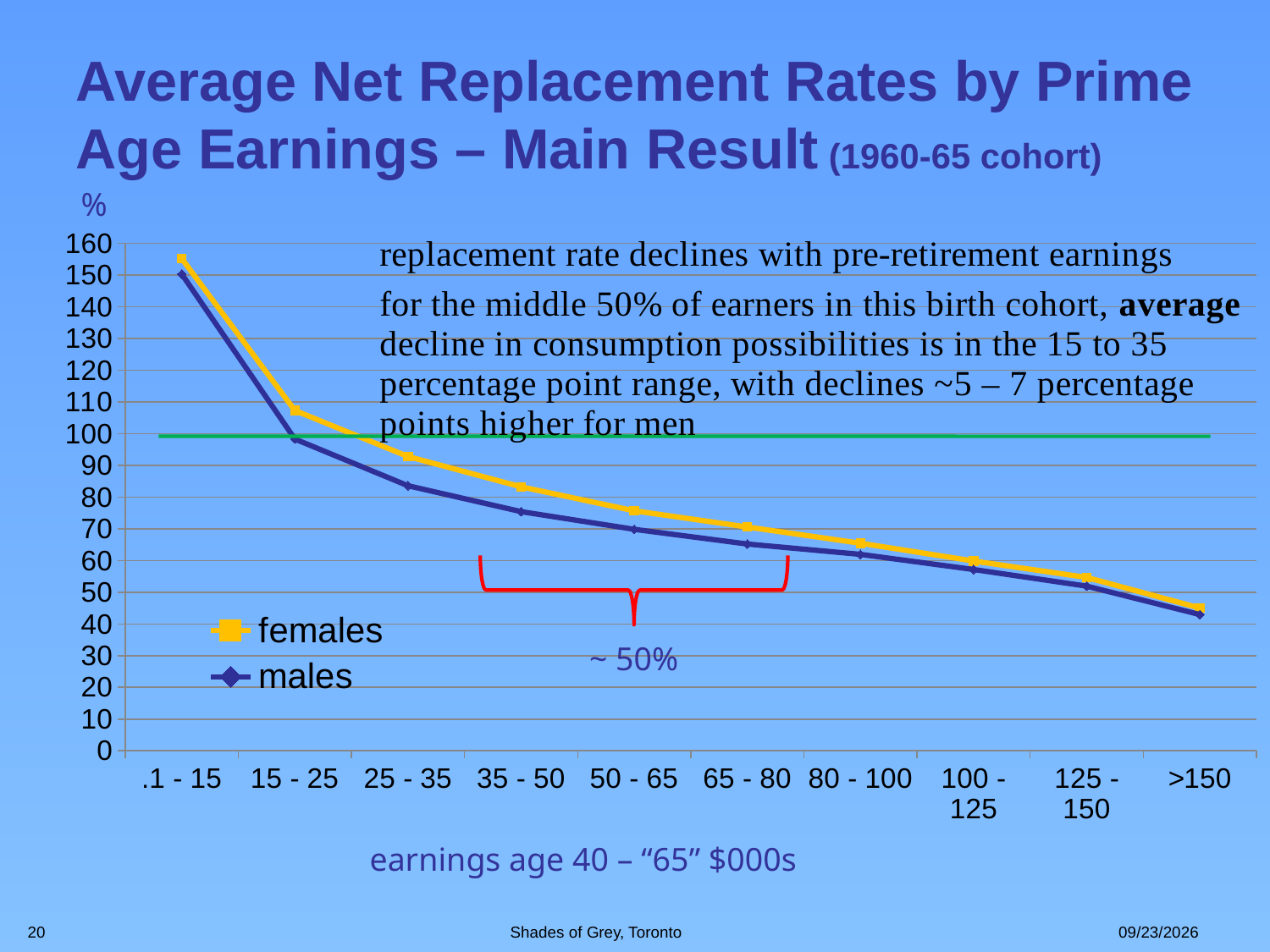
How many series does the legend list? 2 Is the value for females in the 15 - 25 category greater or less than 100? greater How many earnings categories are shown on the x axis? 10 Do the replacement rates rise or fall as earnings increase along the x axis? fall For which earnings category is the males series lowest? >150 Is the value for males in the 35 - 50 category greater or less than 70? greater For which earnings category is the females series highest? .1 - 15 What are the two series named in the legend? females and males Is the value for males in the >150 category greater or less than 50? less In the 15 - 25 category, which series has the larger value, females or males? females What kind of chart is shown on the slide? line chart